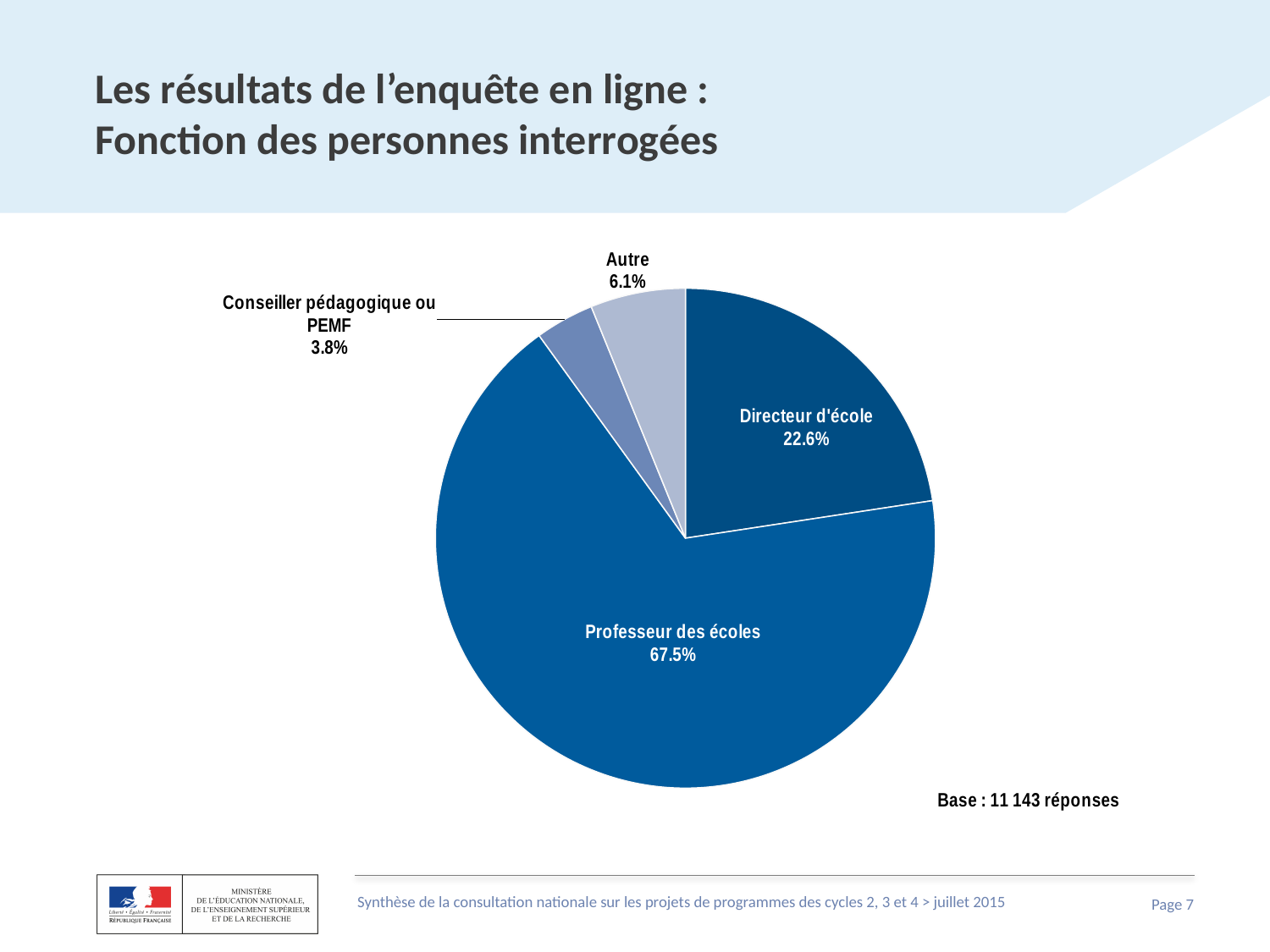
How many categories are shown in the pie chart? 4 Which is larger: the share for 'Autre' or the share for 'Conseiller pédagogique ou PEMF'? Autre What is the difference in percentage points between 'Professeur des écoles' and 'Directeur d'école'? 44.9 What share of respondents are 'Conseiller pédagogique ou PEMF'? 3.8% What share of respondents are 'Professeur des écoles'? 67.5% Which category has the largest share of the pie? Professeur des écoles What share of respondents are 'Directeur d'école'? 22.6% What share of respondents fall into the 'Autre' category? 6.1% What is the difference in percentage points between 'Autre' and 'Conseiller pédagogique ou PEMF'? 2.3 Which category has the smallest share of the pie? Conseiller pédagogique ou PEMF How many responses form the base of the survey, as stated on the slide? 11 143 What type of chart is shown on the slide? Pie chart